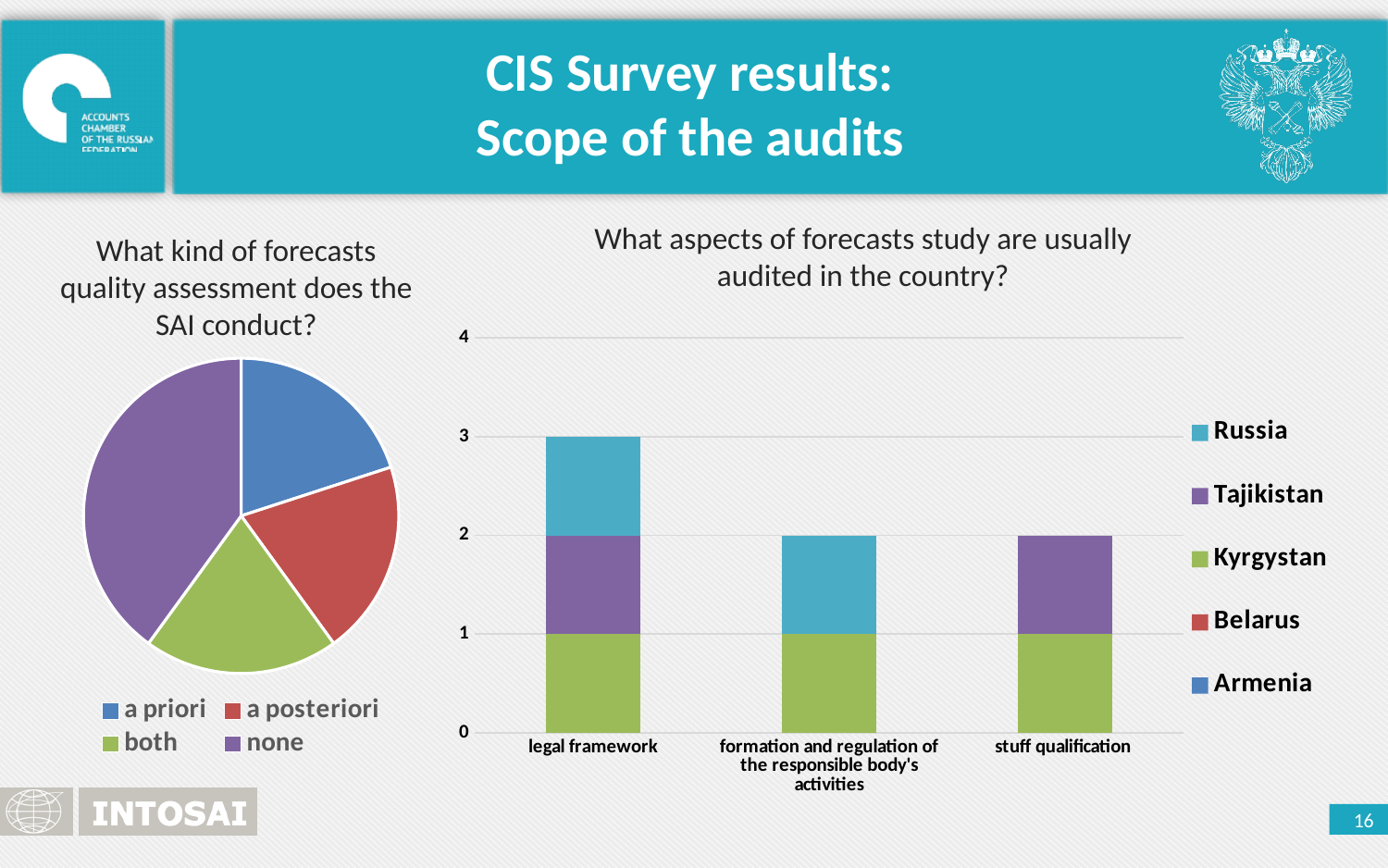
In the bar chart on the right, which series is shown in green? Kyrgystan In the bar chart on the right, what is the total height of the stacked bar for 'stuff qualification'? 2 What type of chart is the chart on the left titled 'What kind of forecasts quality assessment does the SAI conduct?'? pie chart In the pie chart on the left, which category has the largest slice? none In the bar chart on the right, what is the total height of the stacked bar for 'legal framework'? 3 In the bar chart on the right, which countries are stacked in the bar for 'stuff qualification'? Kyrgystan and Tajikistan In the bar chart on the right, what is the difference between the total for 'legal framework' and the total for 'formation and regulation of the responsible body's activities'? 1 In the bar chart on the right, how many categories are shown on the x axis? 3 In the pie chart on the left, how many categories does the legend list? 4 In the bar chart on the right, how many series does the legend list? 5 In the bar chart on the right, which category has the highest stacked bar? legal framework What type of chart is the chart on the right titled 'What aspects of forecasts study are usually audited in the country?'? bar chart